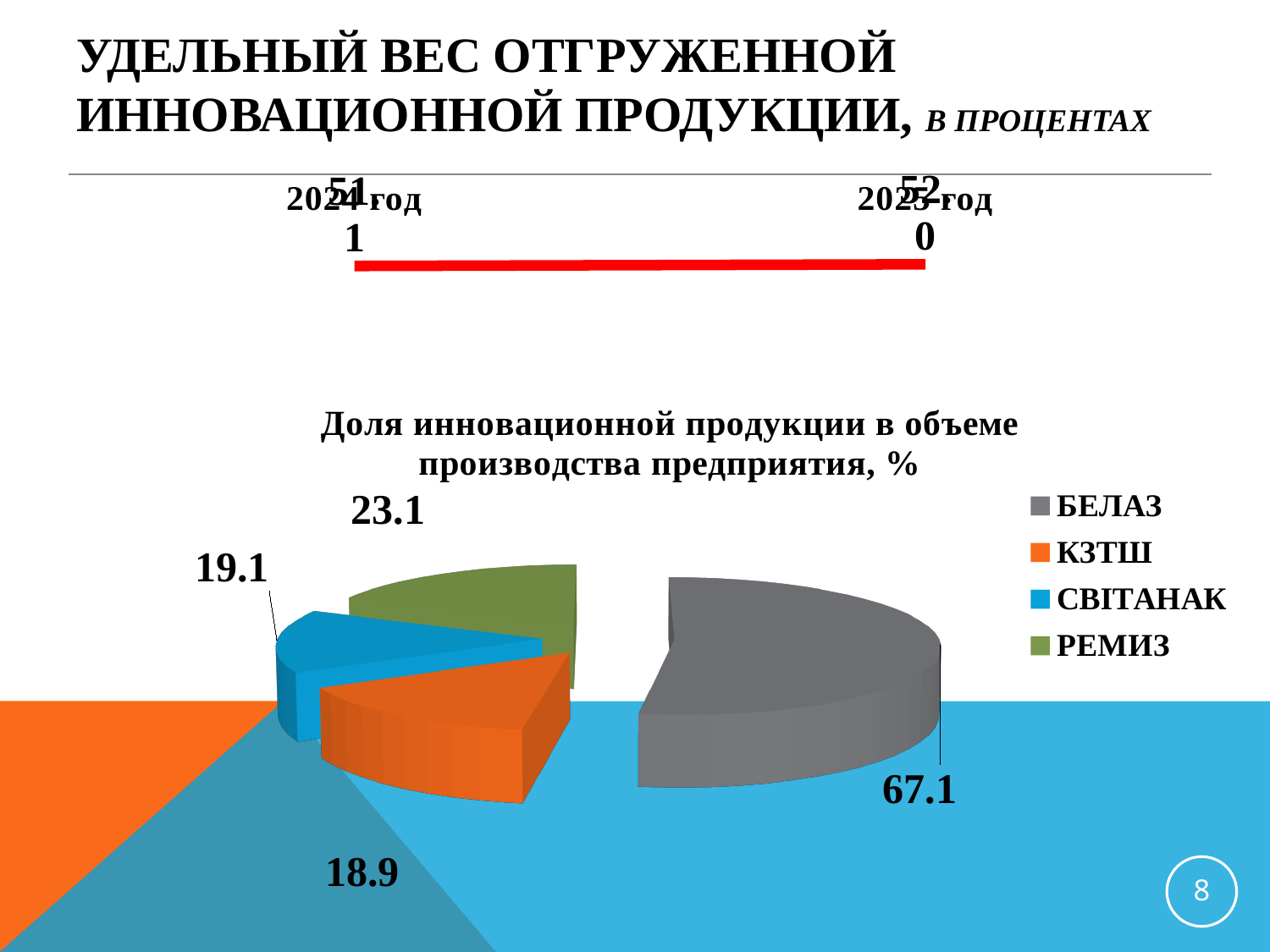
In the pie chart, what is the value for БЕЛАЗ? 67.1 In the pie chart, what is the difference between the values for БЕЛАЗ and КЗТШ? 48.2 Which category has the largest slice in the pie chart? БЕЛАЗ In the pie chart, which is larger: the value for РЕМИЗ or the value for СВІТАНАК? РЕМИЗ What colour is the БЕЛАЗ slice in the pie chart? gray How many slices does the pie chart have? 4 What type of chart is shown under the title "Доля инновационной продукции в объеме производства предприятия, %"? pie chart In the pie chart, what is the value for КЗТШ? 18.9 In the pie chart, what is the value for СВІТАНАК? 19.1 In the pie chart, what is the value for РЕМИЗ? 23.1 Which category has the smallest value in the pie chart? КЗТШ How many entries does the legend of the pie chart list? 4